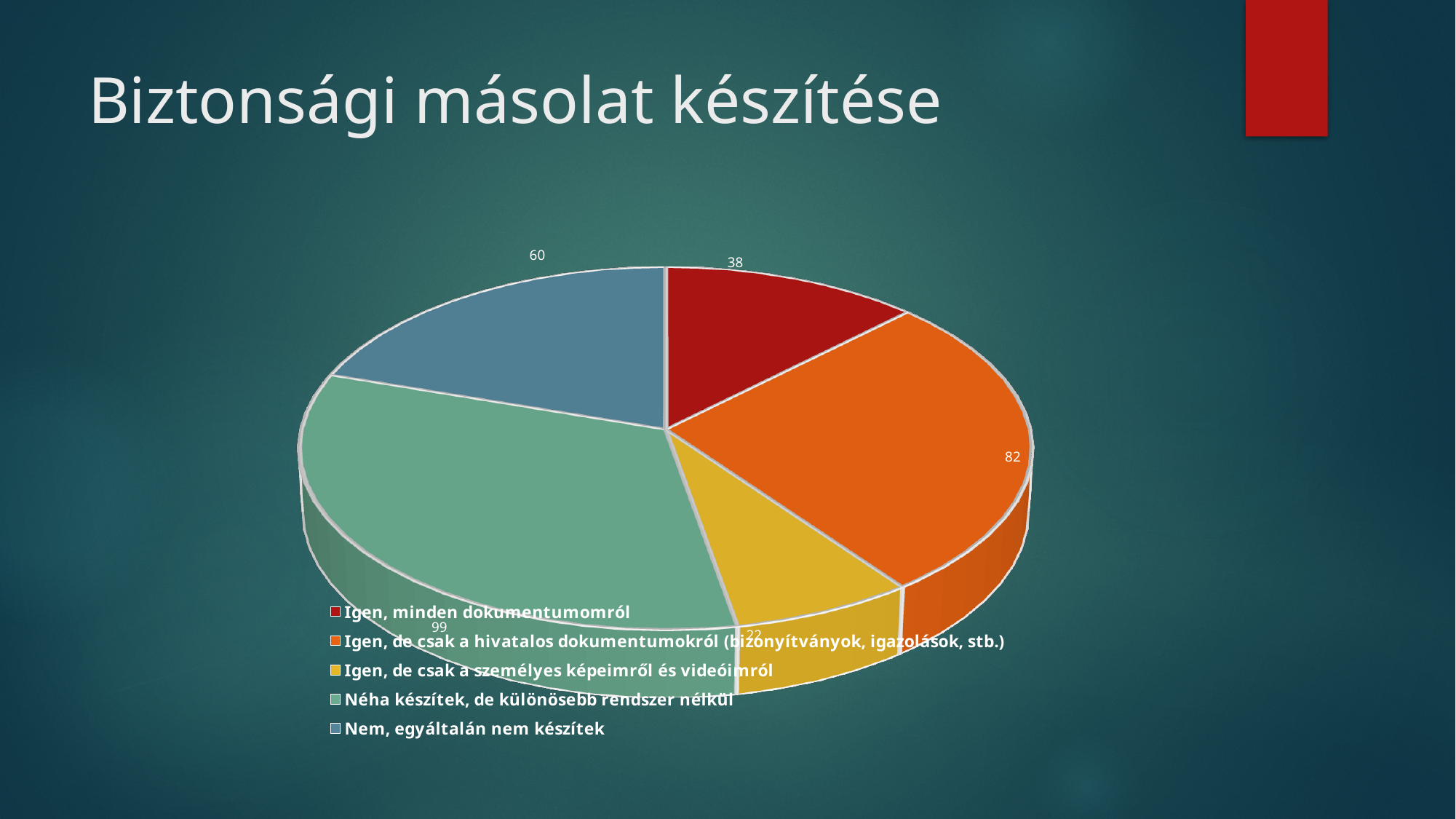
What kind of chart is shown on the slide? Pie chart Which category has the largest slice of the pie? Néha készítek, de különösebb rendszer nélkül Which is larger: the value for "Nem, egyáltalán nem készítek" or the value for "Igen, minden dokumentumomról"? Nem, egyáltalán nem készítek Which category has the smallest slice of the pie? Igen, de csak a személyes képeimről és videóimról What is the value for "Igen, de csak a személyes képeimről és videóimról"? 22 What is the title of the slide containing the chart? Biztonsági másolat készítése What is the value for "Nem, egyáltalán nem készítek"? 60 What is the value for "Néha készítek, de különösebb rendszer nélkül"? 99 What is the value for "Igen, minden dokumentumomról"? 38 How many categories does the pie chart have? 5 What is the difference between the values for "Néha készítek, de különösebb rendszer nélkül" and "Igen, de csak a hivatalos dokumentumokról (bizonyítványok, igazolások, stb.)"? 17 What is the value for "Igen, de csak a hivatalos dokumentumokról (bizonyítványok, igazolások, stb.)"? 82